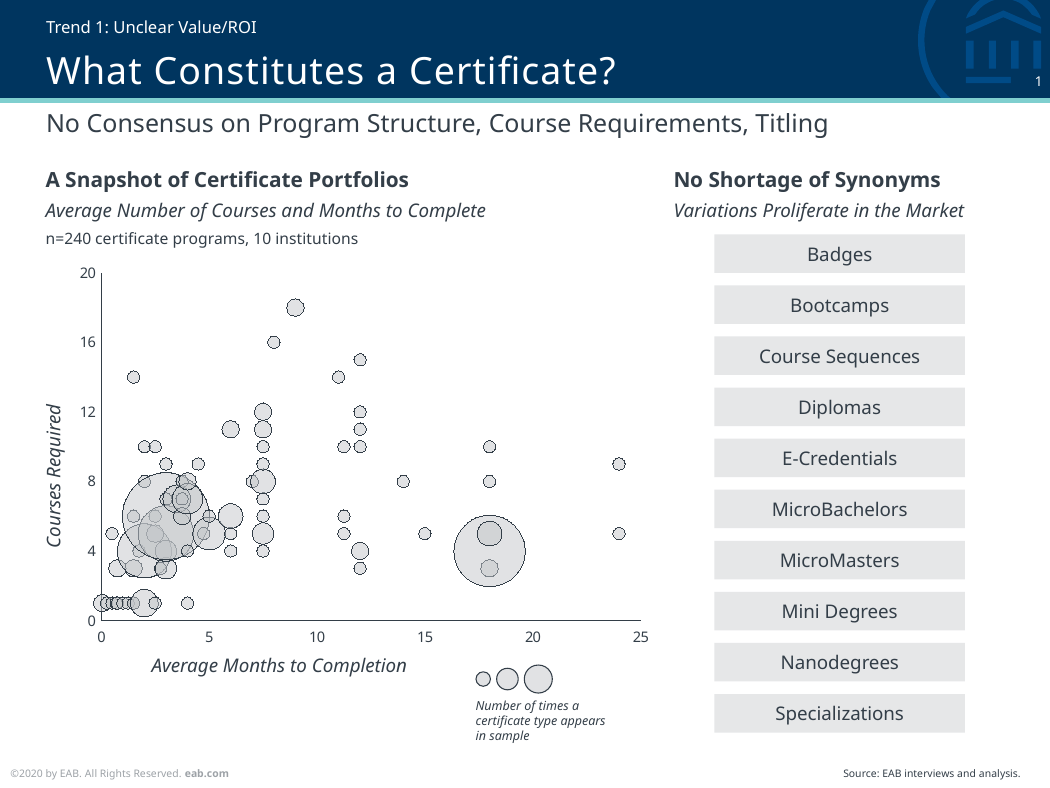
Is the Courses Required value of the lowest row of bubbles on the chart greater or less than 4? less How many institutions does the chart say the sample covers? 10 Is the Average Months to Completion value of the rightmost bubble on the chart greater or less than 20? greater What does the size of each bubble in the chart represent? Number of times a certificate type appears in sample What is the title of the chart on the left of the slide? A Snapshot of Certificate Portfolios What kind of chart is shown under 'A Snapshot of Certificate Portfolios'? bubble chart How many certificate programs does the chart say are included in the sample? 240 Is the Courses Required value of the highest bubble on the chart greater or less than 16? greater